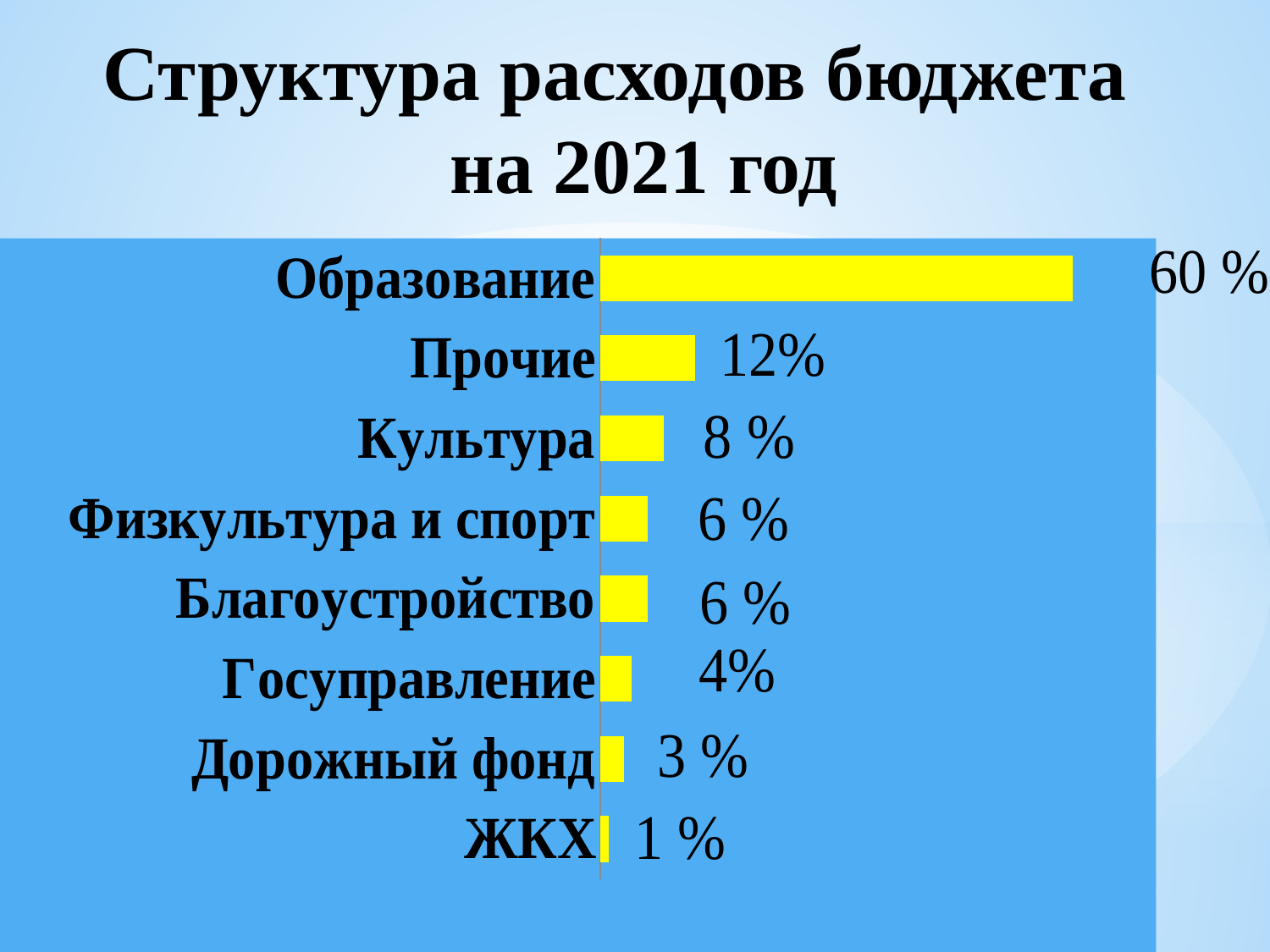
Which category has the highest value? Образование What is the difference between the values for Культура and Госуправление? 4 % What is the title of the slide? Структура расходов бюджета на 2021 год How many categories are shown in the chart? 8 What is the value for Образование? 60 % What is the value for Дорожный фонд? 3 % What is the value for Культура? 8 % Which category has the lowest value? ЖКХ What is the difference between the values for Образование and Прочие? 48 % What is the value for Прочие? 12% What kind of chart is shown on the slide? Bar chart Which is larger, the value for Прочие or the value for Культура? Прочие